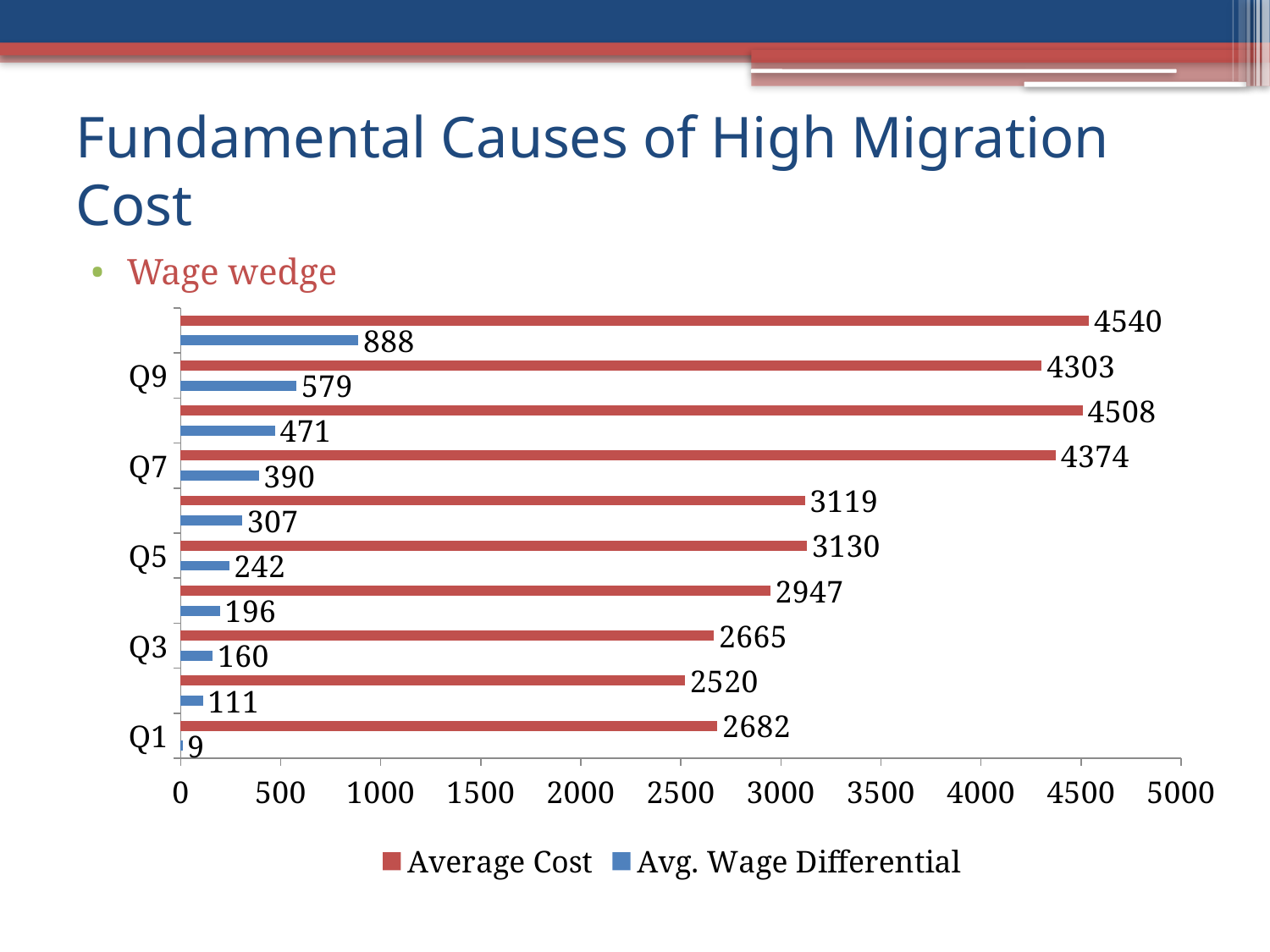
What is the Avg. Wage Differential for Q9? 579 What is the Avg. Wage Differential for Q5? 242 What is the Average Cost for Q7? 4374 Which labeled quarter has the lowest Avg. Wage Differential? Q1 What is the Average Cost for Q1? 2682 Which colour represents the Avg. Wage Differential series? Blue Which is larger, the Average Cost for Q5 or the Average Cost for Q3? Q5 What kind of chart is shown on the slide? Bar chart How many series does the legend list? 2 What is the highest Average Cost value shown on the chart? 4540 Is the Average Cost for Q7 greater or less than 4000? greater What is the difference between the Average Cost for Q9 and the Average Cost for Q3? 1638